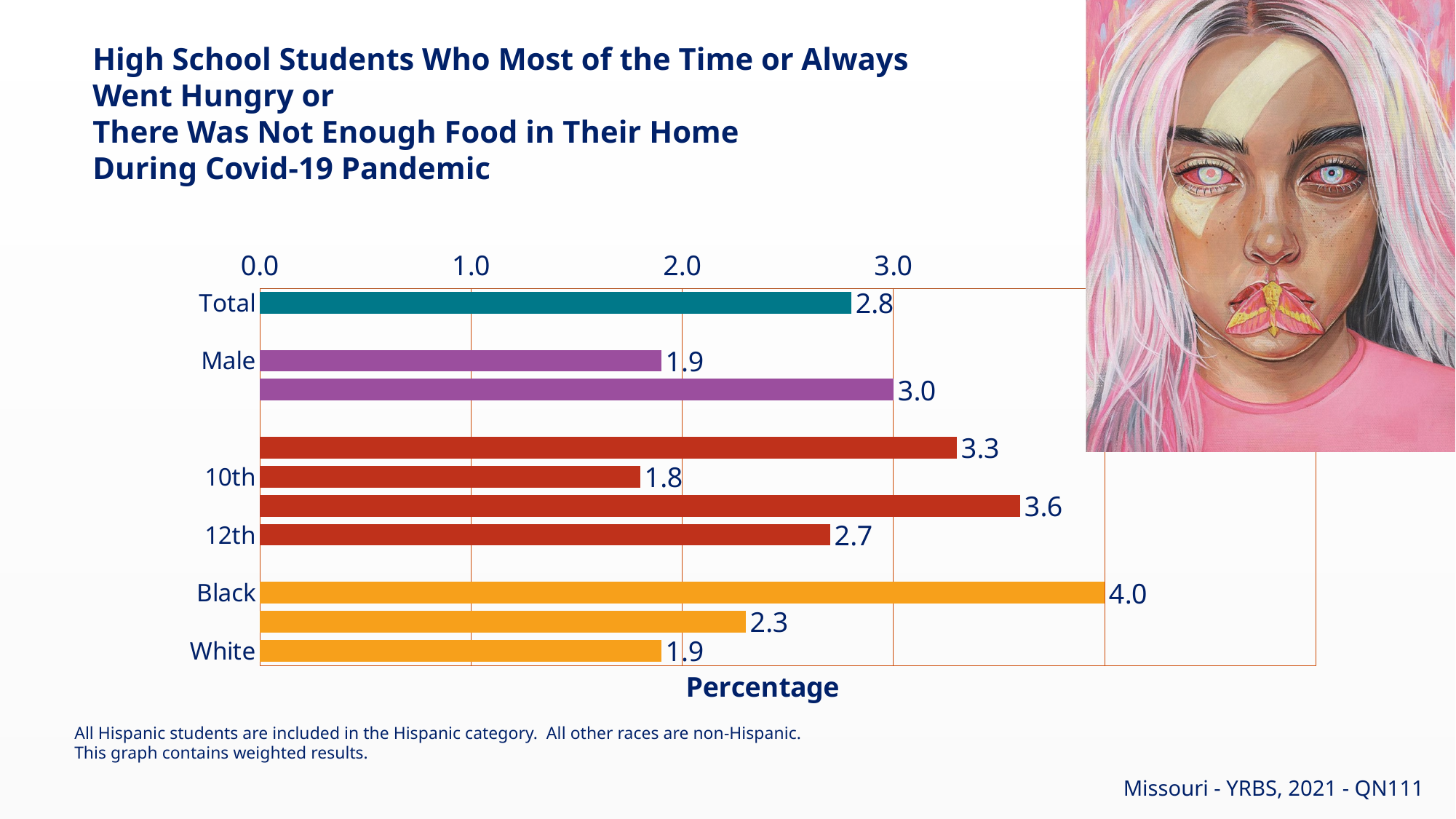
What is the difference between the values for Black and White students? 2.1 What is the value for 10th grade? 1.8 What kind of chart is shown on the slide? bar chart What is the value for Total? 2.8 Which labeled category has the lowest value? 10th What is the label of the horizontal axis? Percentage How many bars are plotted in the chart? 10 What is the value for Black students? 4.0 Which labeled category has the highest value? Black What is the value for 12th grade? 2.7 Which is larger, the value for Total or the value for 12th grade? Total Is the value for Male greater or less than 2.0? less